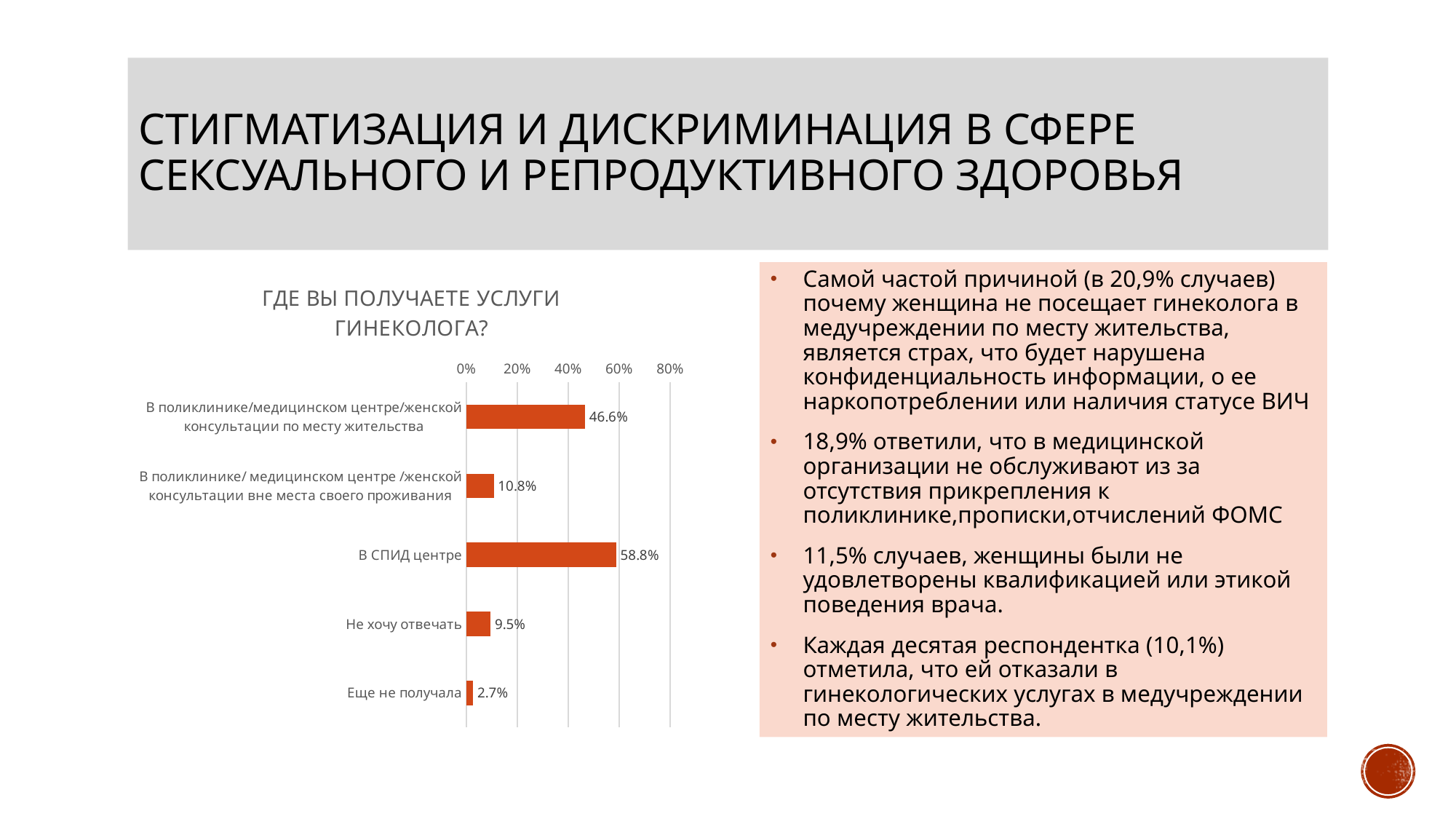
What is the value for 'Еще не получала'? 2.7% Which is larger: the value for 'В поликлинике/ медицинском центре /женской консультации вне места своего проживания' or the value for 'Не хочу отвечать'? В поликлинике/ медицинском центре /женской консультации вне места своего проживания Is the value for 'В СПИД центре' greater or less than 40%? greater What is the difference between the values for 'В СПИД центре' and 'В поликлинике/медицинском центре/женской консультации по месту жительства'? 12.2% How many categories are shown in the chart? 5 What is the value for 'В поликлинике/медицинском центре/женской консультации по месту жительства'? 46.6% What is the title of the chart? ГДЕ ВЫ ПОЛУЧАЕТЕ УСЛУГИ ГИНЕКОЛОГА? What is the value for 'В СПИД центре'? 58.8% Which category has the lowest value? Еще не получала Which category has the highest value? В СПИД центре What kind of chart is shown on the slide? Bar chart What is the value for 'Не хочу отвечать'? 9.5%